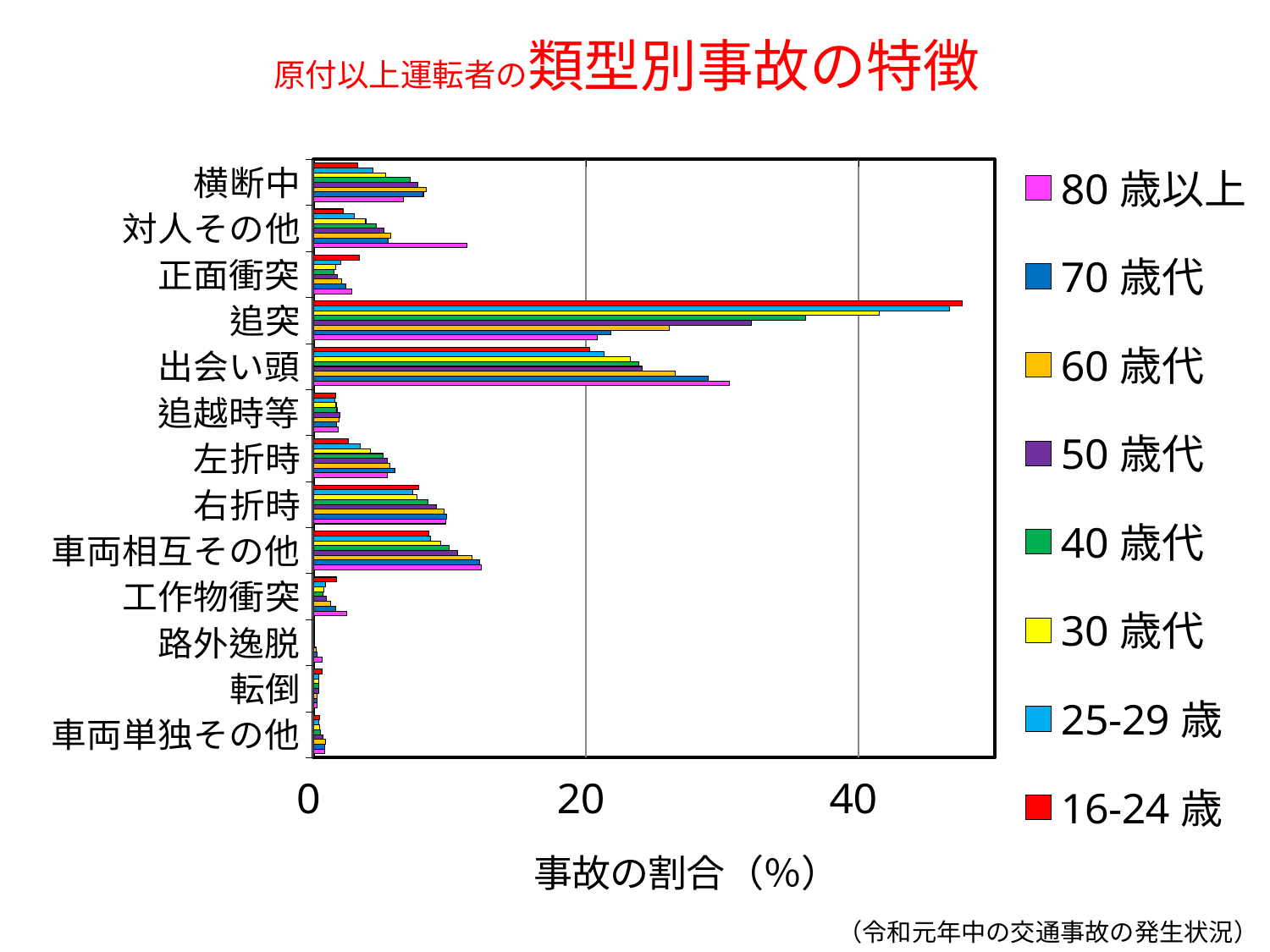
How many accident-type categories are listed on the vertical axis? 13 Which age group has the highest value for 出会い頭? 80 歳以上 Which age group has the highest value for 対人その他? 80 歳以上 Is the value for 追突 in the 40 歳代 series greater or less than 40? less What kind of chart is shown on the slide? bar chart How many age-group series does the legend list? 8 What is the title of the horizontal axis? 事故の割合（%） For 追突, which is larger: the value for 16-24 歳 or the value for 80 歳以上? 16-24 歳 Is the value for 出会い頭 in the 80 歳以上 series greater or less than 20? greater Which age group has the highest value for 追突? 16-24 歳 Is the value for 追突 in the 16-24 歳 series greater or less than 40? greater